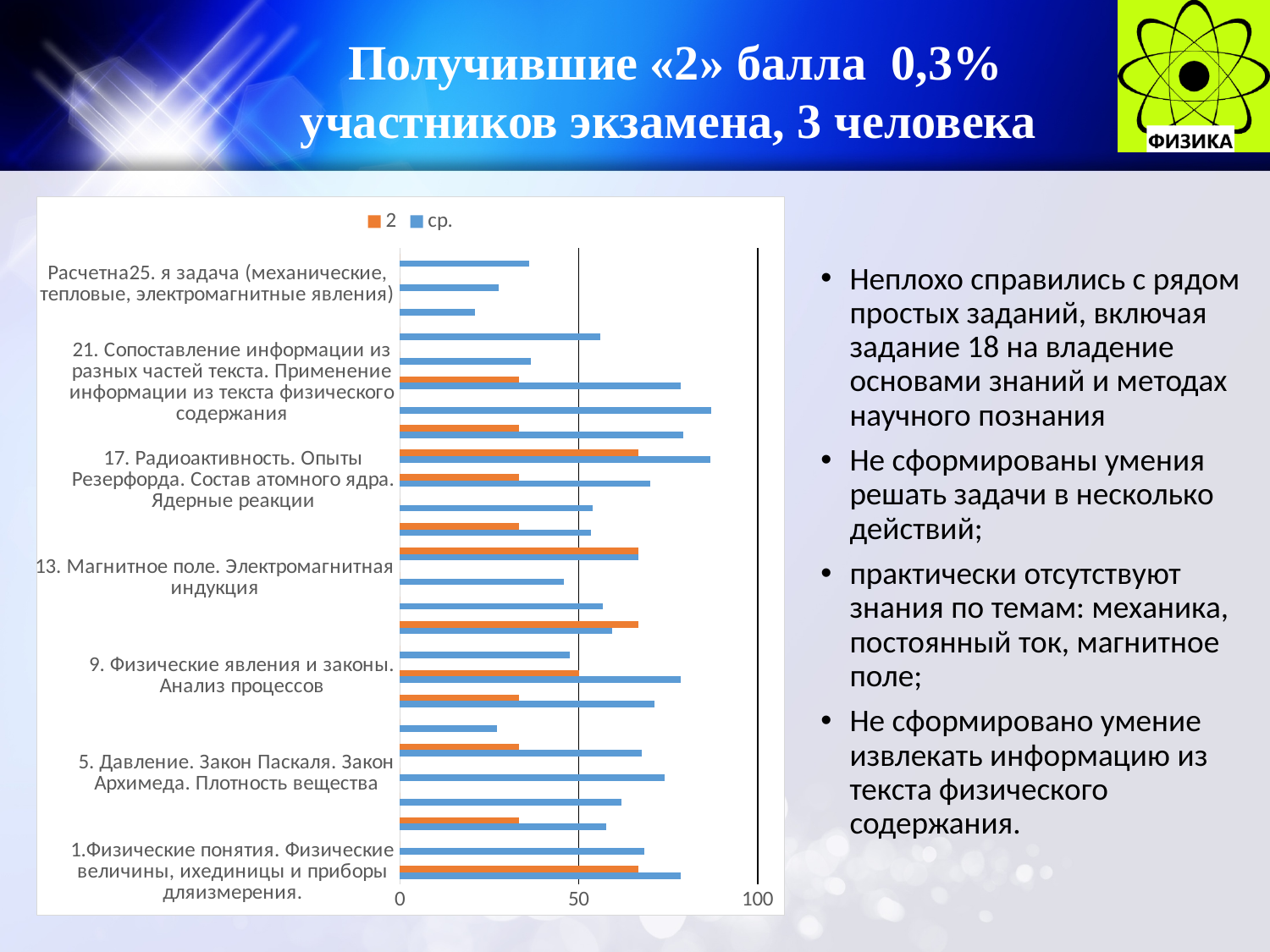
What is the maximum value shown on the chart's horizontal axis? 100 How many series does the chart legend list? 2 Is the value of series 2 for task 17 (Радиоактивность. Опыты Резерфорда) greater or less than 50? less Is the ср. value for task 1 (Физические понятия. Физические величины, их единицы и приборы для измерения) greater or less than 50? greater What kind of chart is shown on the slide? bar chart Is the ср. value for task 25 (Расчетная задача) greater or less than 50? less For task 9 (Физические явления и законы. Анализ процессов), which series has the larger value, 2 or ср.? ср. What are the two series named in the chart legend? 2 and ср. For task 17 (Радиоактивность. Опыты Резерфорда), which series has the larger value, 2 or ср.? ср.